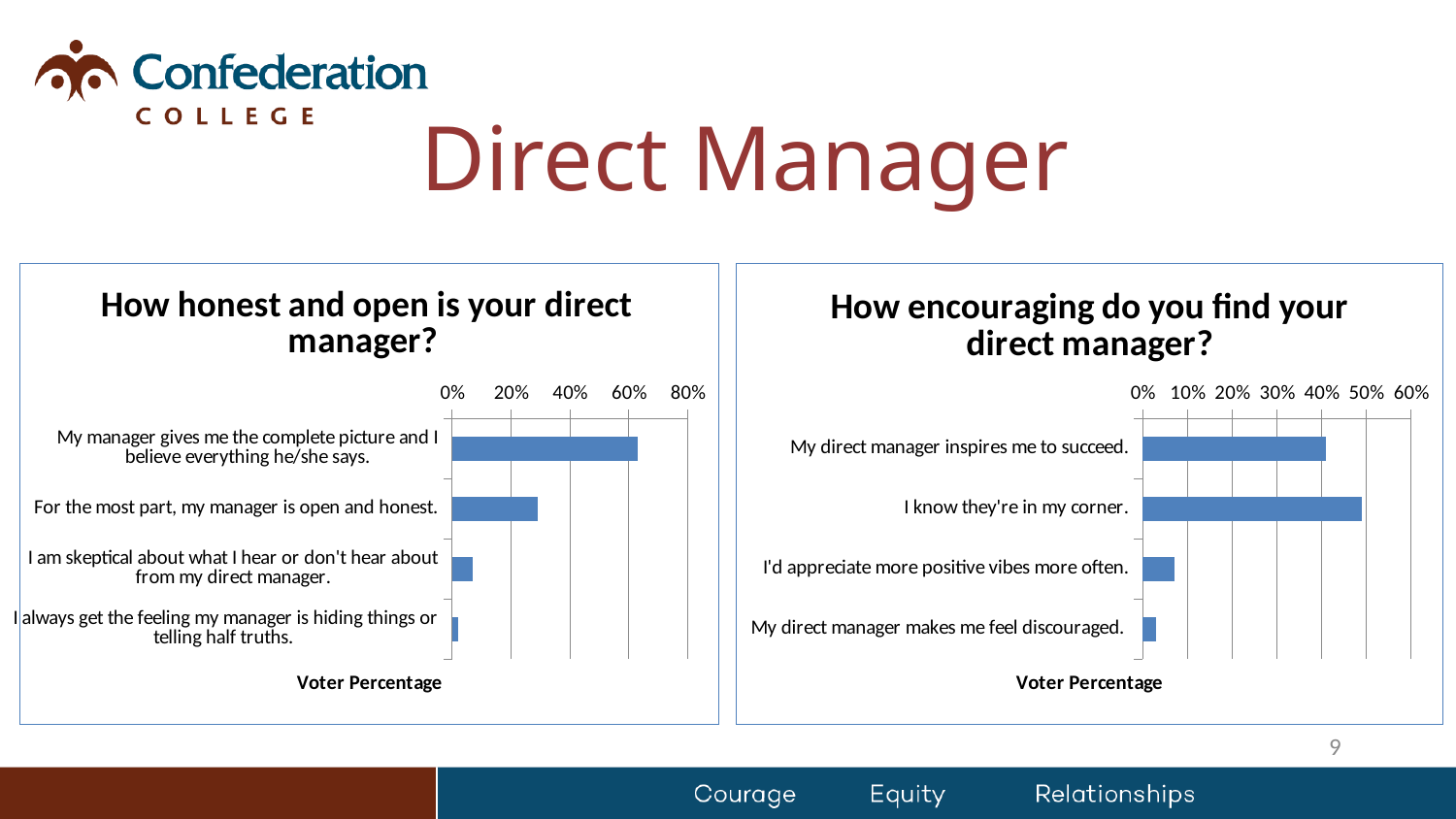
On the chart titled "How honest and open is your direct manager?", which category has the lowest value? I always get the feeling my manager is hiding things or telling half truths. On the chart titled "How encouraging do you find your direct manager?", is the value for "I'd appreciate more positive vibes more often." greater or less than 10%? less On the chart titled "How honest and open is your direct manager?", is the value for "For the most part, my manager is open and honest." greater or less than 40%? less On the chart titled "How encouraging do you find your direct manager?", is the value for "I know they're in my corner." greater or less than 40%? greater On the chart titled "How encouraging do you find your direct manager?", which is larger: the value for "My direct manager inspires me to succeed." or the value for "I'd appreciate more positive vibes more often."? My direct manager inspires me to succeed. On the chart titled "How honest and open is your direct manager?", which category has the highest value? My manager gives me the complete picture and I believe everything he/she says. On the chart titled "How encouraging do you find your direct manager?", which category has the lowest value? My direct manager makes me feel discouraged. What is the axis title shown below the bars on the chart titled "How honest and open is your direct manager?"? Voter Percentage How many categories are shown on the chart titled "How honest and open is your direct manager?"? 4 On the chart titled "How encouraging do you find your direct manager?", which category has the highest value? I know they're in my corner. What kind of chart is the chart titled "How encouraging do you find your direct manager?"? bar chart